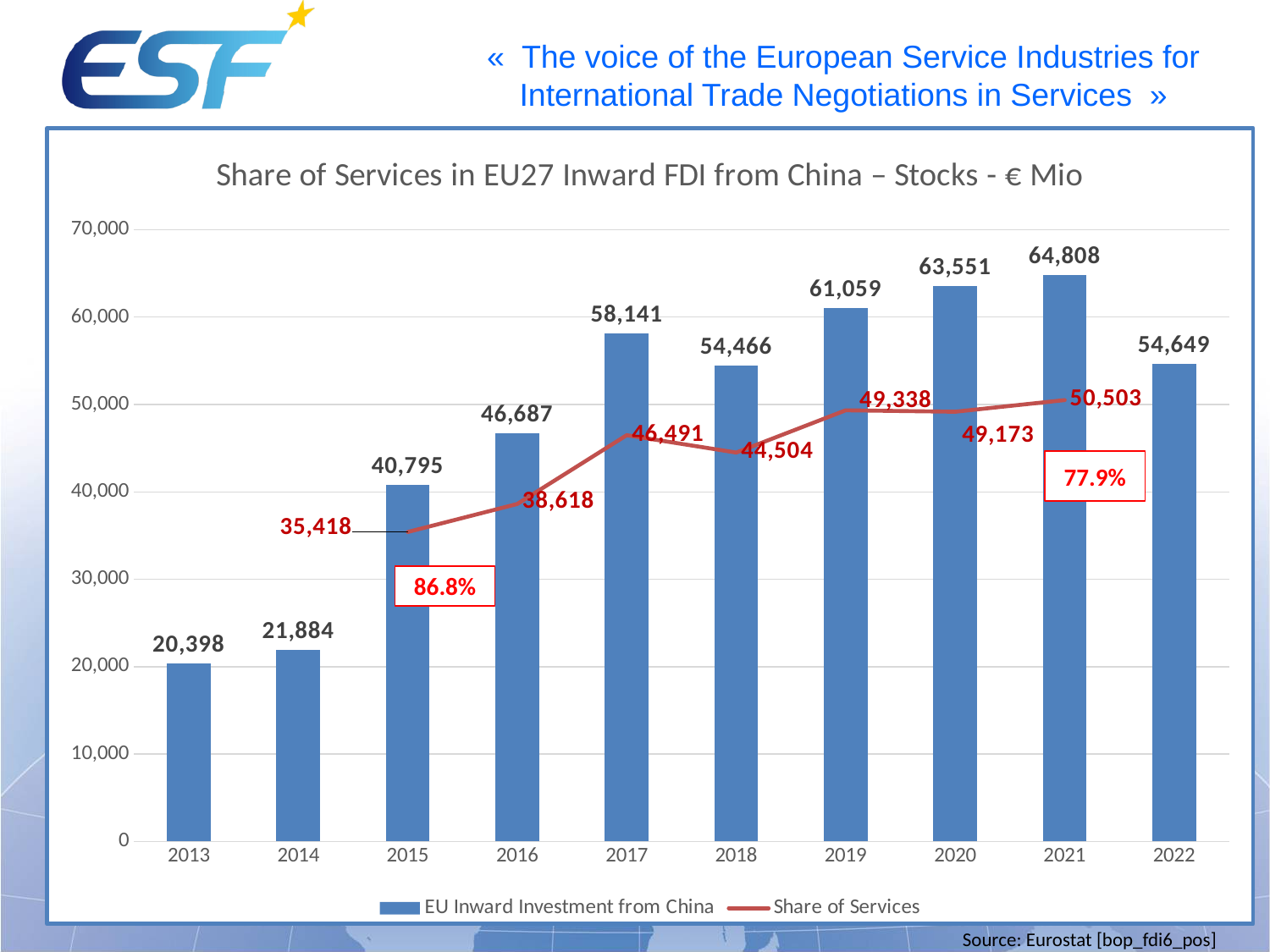
What is the Share of Services value shown for 2019? 49,338 What percentage is shown in the red box near the 2015 bar? 86.8% Which year has the lowest EU Inward Investment from China bar? 2013 How many series does the legend list? 2 What is the difference between the EU Inward Investment from China values for 2021 and 2022? 10,159 Do the EU Inward Investment from China bars rise or fall from 2013 to 2017? Rise Which year has a larger EU Inward Investment from China bar, 2018 or 2019? 2019 What kind of chart is shown on the slide? A bar chart combined with a line chart What is the difference between the Share of Services values for 2021 and 2015? 15,085 What is the value of EU Inward Investment from China in 2017? 58,141 Which year has the highest EU Inward Investment from China bar? 2021 How many years are shown on the x axis of the chart? 10